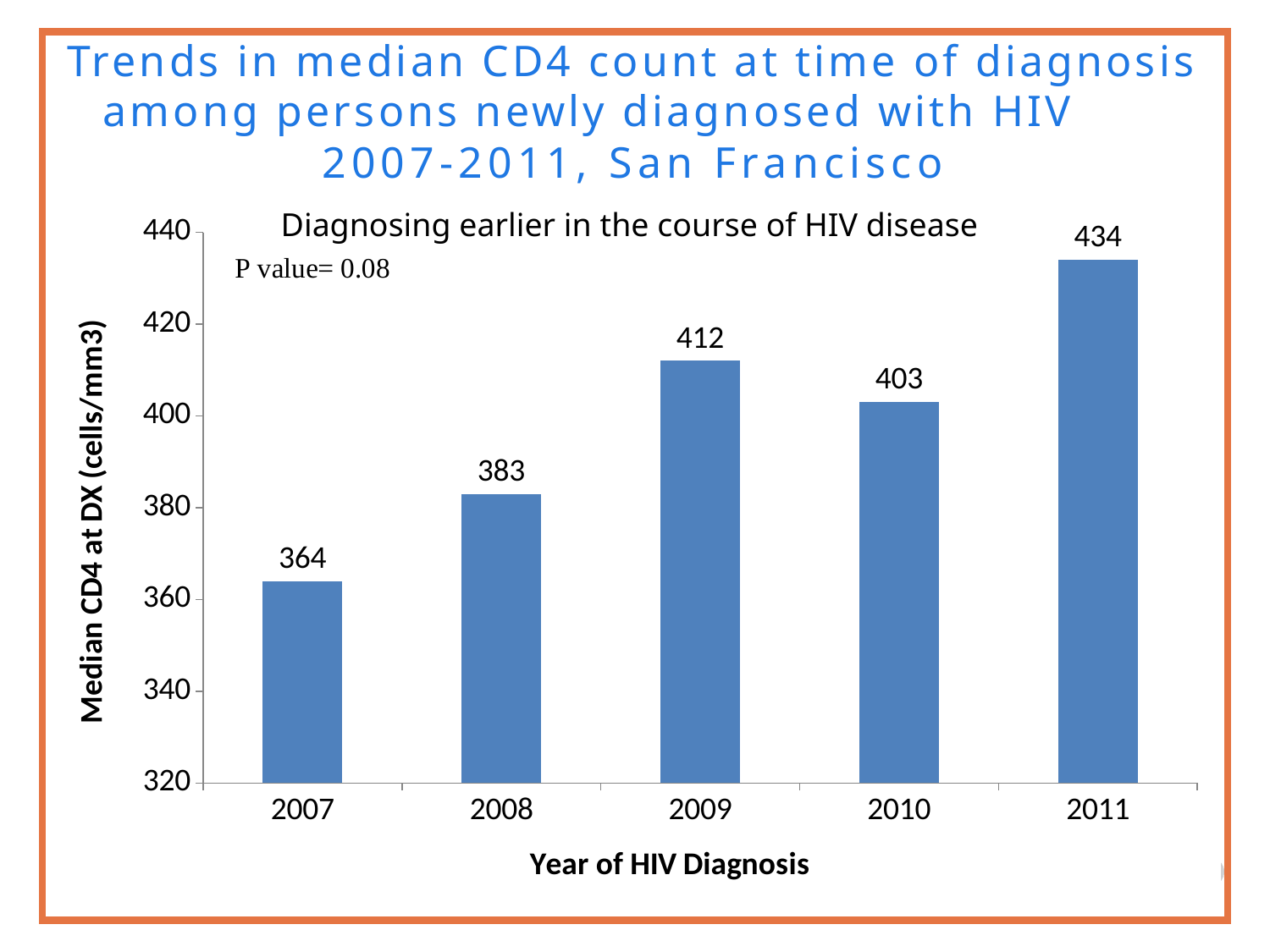
What is the difference in median CD4 count between 2011 and 2007? 70 Which year has the highest median CD4 count at diagnosis? 2011 What is the median CD4 count at diagnosis for 2010? 403 What is the median CD4 count at diagnosis for 2007? 364 What type of chart is shown on the slide? bar chart What is the difference in median CD4 count between 2009 and 2010? 9 Which year has a higher median CD4 count, 2008 or 2010? 2010 Which year has the lowest median CD4 count at diagnosis? 2007 What P value is printed on the chart? 0.08 How many years are shown on the x axis of the chart? 5 What is the median CD4 count at diagnosis for 2009? 412 Is the median CD4 count for 2008 greater or less than 400? less